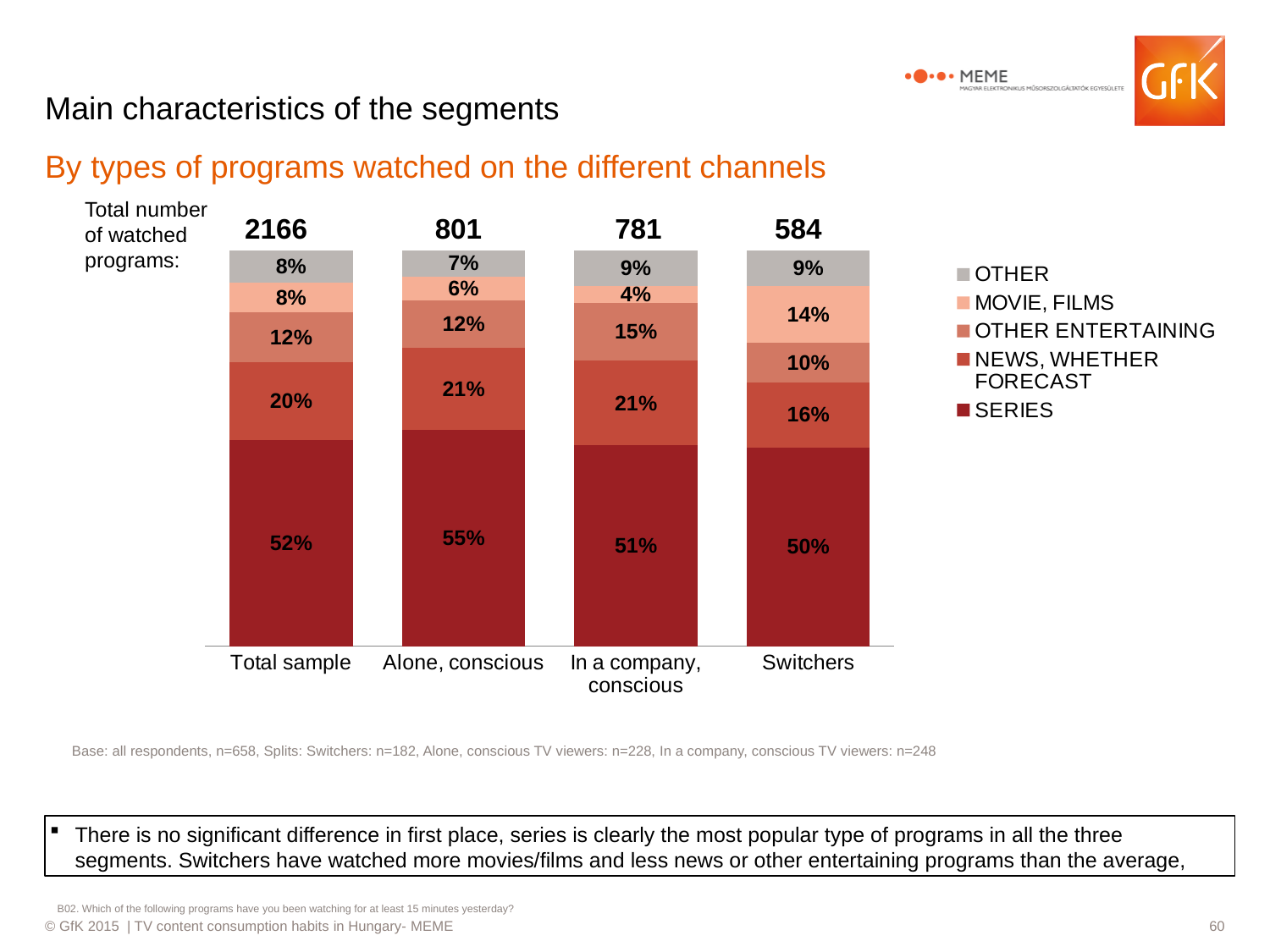
What is the difference in the MOVIE, FILMS share between Switchers and the Total sample? 6 percentage points What kind of chart is shown on the slide? Stacked bar chart What share of programs watched by Switchers were SERIES? 50% Which program type is shown at the bottom of each stacked bar? SERIES What share of programs watched by the Alone, conscious segment were MOVIE, FILMS? 6% Which segment has the highest share of SERIES? Alone, conscious Which segment has the lowest share of MOVIE, FILMS? In a company, conscious How many series does the legend list? 5 Which is larger: the NEWS, WHETHER FORECAST share for Switchers or for the Total sample? Total sample What share of programs watched by the In a company, conscious segment were OTHER ENTERTAINING? 15% What is the total number of watched programs shown above the Total sample bar? 2166 How many segments (bars) are shown in the chart? 4